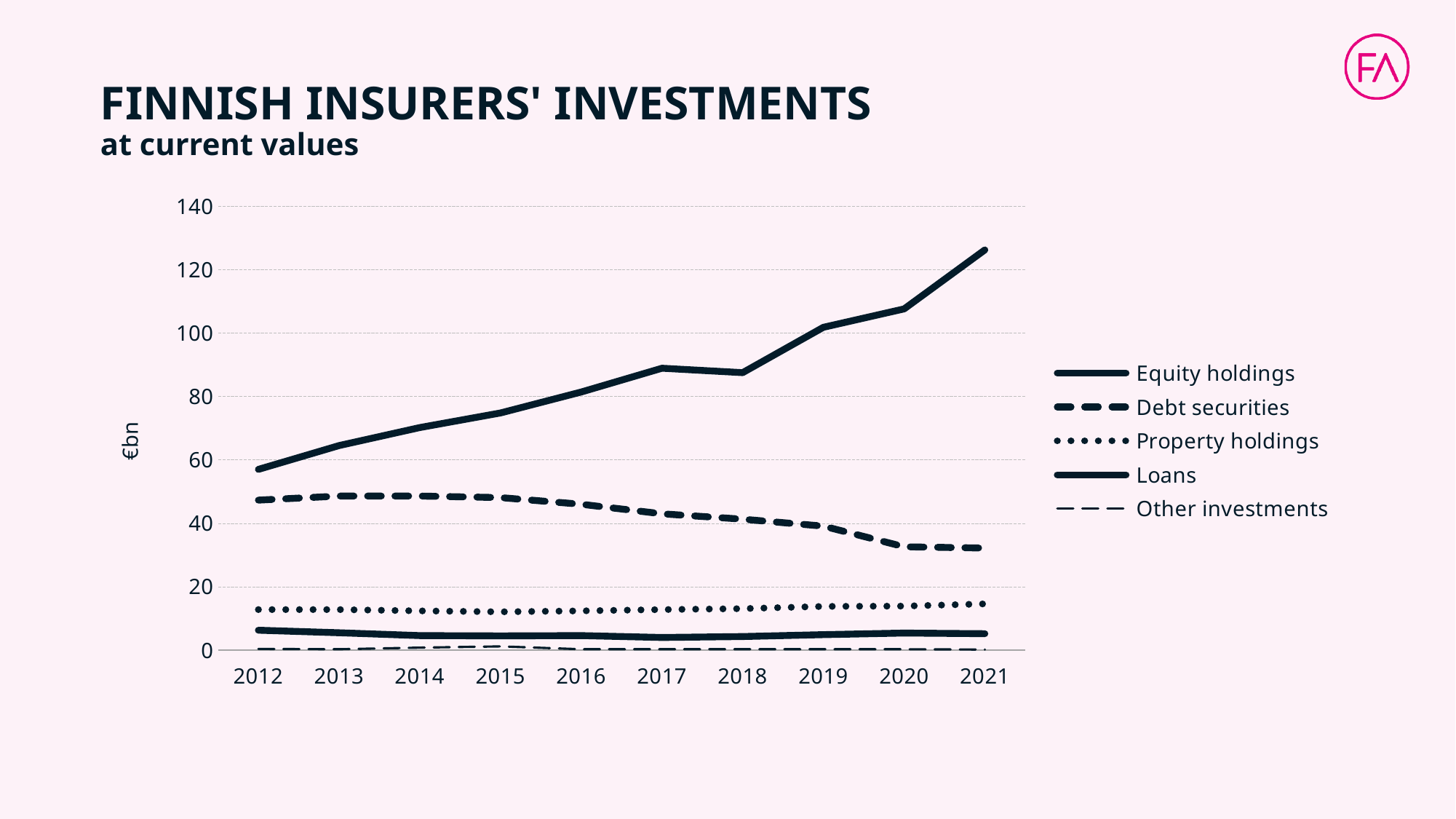
How many years are plotted along the x axis? 10 How many series does the legend list? 5 Is the value for Debt securities in 2021 greater or less than 40? less Is the value for Equity holdings in 2021 greater or less than 120? greater Is the value for Property holdings in 2021 greater or less than 20? less Do the values for Debt securities rise or fall from 2012 to 2021? fall Do the values for Equity holdings rise or fall from 2012 to 2021? rise What kind of chart is shown on the slide? line chart What unit is shown on the y axis label? €bn Which series has the lowest value in 2021? Other investments Which series has the highest value in 2021? Equity holdings